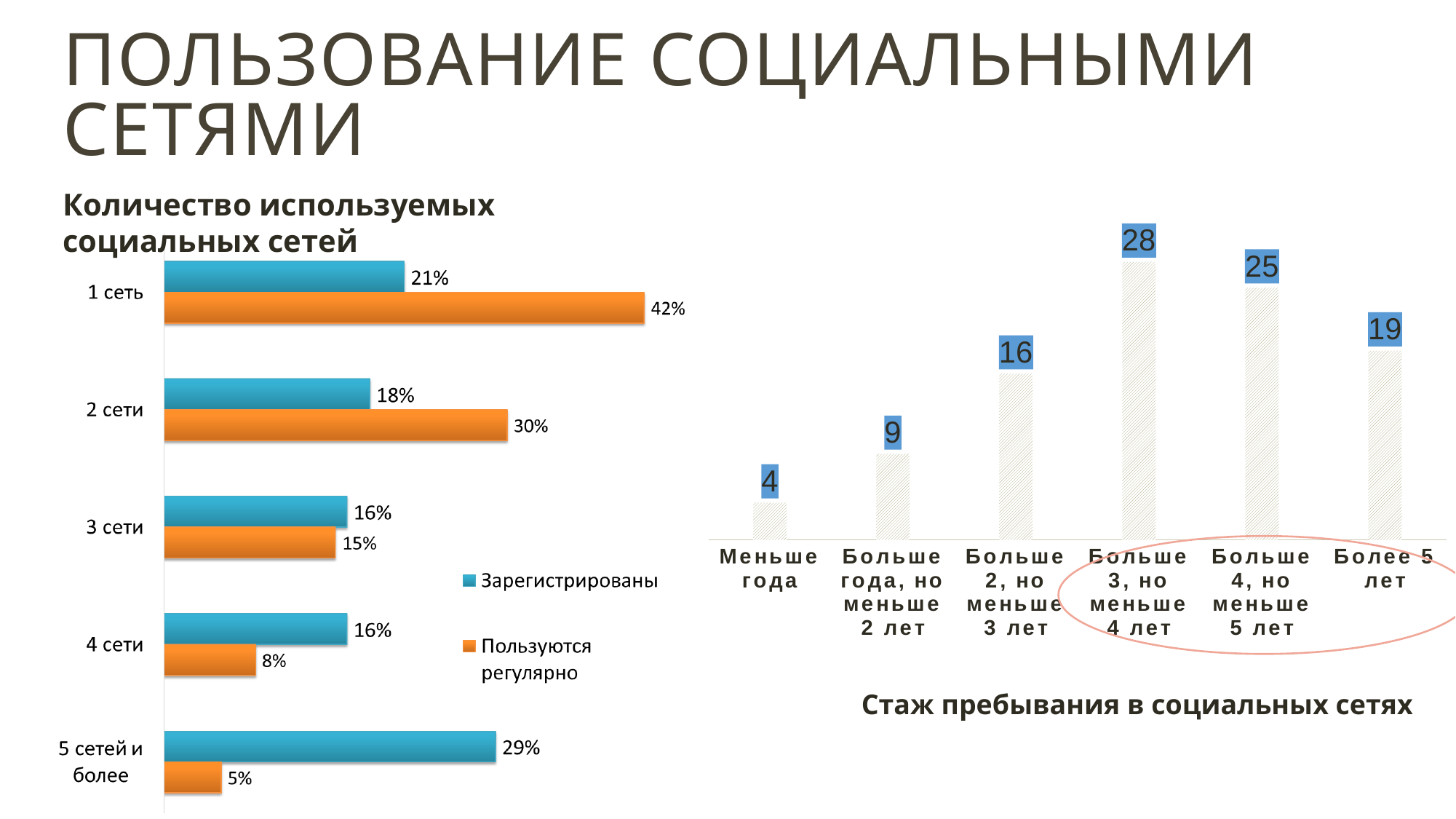
In the chart 'Количество используемых социальных сетей', which category has the lowest 'Пользуются регулярно' value? 5 сетей и более In the chart 'Количество используемых социальных сетей', what is the value for 'Зарегистрированы' in the '1 сеть' category? 21% In the chart 'Количество используемых социальных сетей', which is larger for '4 сети': 'Зарегистрированы' or 'Пользуются регулярно'? Зарегистрированы In the chart 'Стаж пребывания в социальных сетях', what is the difference between 'Больше 4, но меньше 5 лет' and 'Более 5 лет'? 6 In the chart 'Количество используемых социальных сетей', what is the difference between 'Пользуются регулярно' and 'Зарегистрированы' for '1 сеть'? 21% In the chart 'Стаж пребывания в социальных сетях', what is the value for 'Больше 2, но меньше 3 лет'? 16 How many categories are shown in the chart 'Количество используемых социальных сетей'? 5 How many series does the legend of the chart 'Количество используемых социальных сетей' list? 2 In the chart 'Количество используемых социальных сетей', what is the value for 'Пользуются регулярно' in the '2 сети' category? 30% What kind of chart is 'Стаж пребывания в социальных сетях'? Bar chart In the chart 'Стаж пребывания в социальных сетях', which category has the highest value? Больше 3, но меньше 4 лет In the chart 'Количество используемых социальных сетей', which category has the highest 'Пользуются регулярно' value? 1 сеть